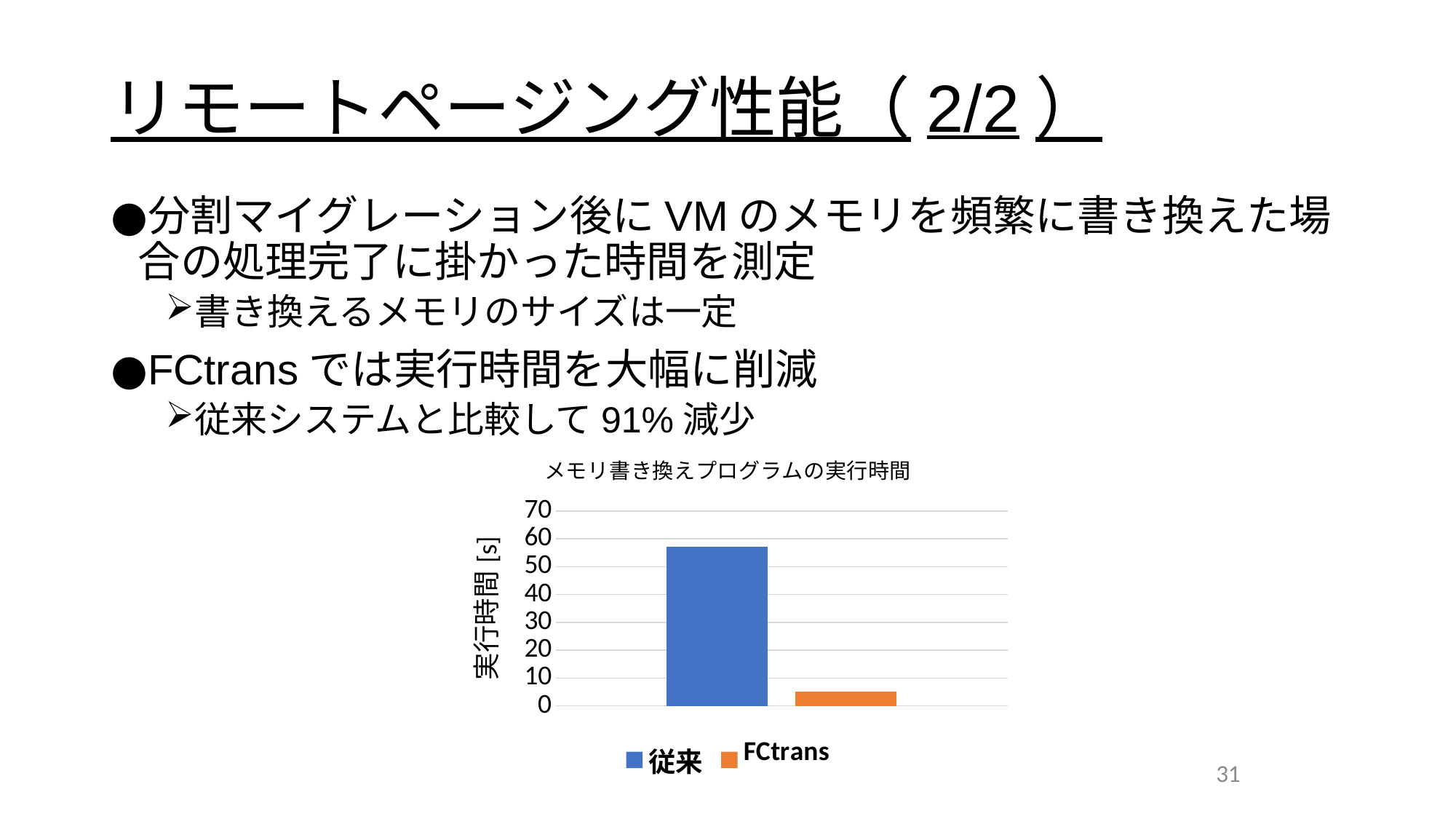
Is the value for 従来 greater or less than 60? less What is the label of the vertical axis? 実行時間 [s] Is the value for FCtrans greater or less than 10? less Is the value for 従来 greater or less than 50? greater How many series does the legend list? 2 Which series has the highest execution time? 従来 Which is larger, the execution time for 従来 or for FCtrans? 従来 What is the title of the chart? メモリ書き換えプログラムの実行時間 What kind of chart is shown on the slide? bar chart Which series has the lowest execution time? FCtrans How many bars are plotted in the chart? 2